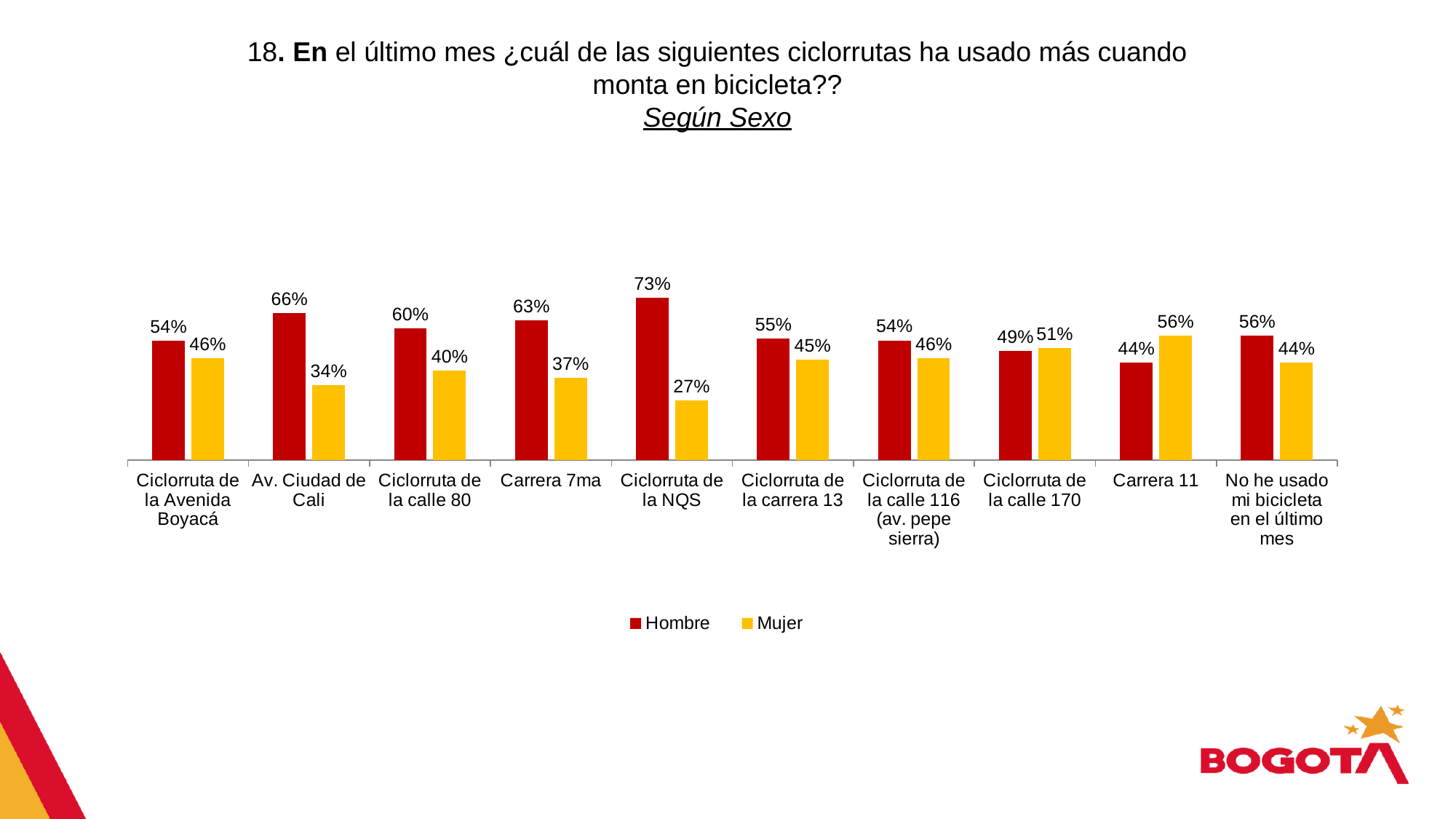
Which category has the lowest Mujer value? Ciclorruta de la NQS What is the Mujer value for Av. Ciudad de Cali? 34% Which colour represents the Mujer series? Yellow Which category has the highest Hombre value? Ciclorruta de la NQS How many categories are shown on the x axis? 10 What is the Hombre value for Ciclorruta de la NQS? 73% How many series does the legend list? 2 What is the difference between the Hombre values for Av. Ciudad de Cali and Ciclorruta de la calle 80? 6% What is the difference between the Hombre and Mujer values for Ciclorruta de la NQS? 46% What is the Mujer value for Carrera 11? 56% Which is larger for Carrera 11, the Hombre value or the Mujer value? Mujer What kind of chart is shown on the slide? Bar chart